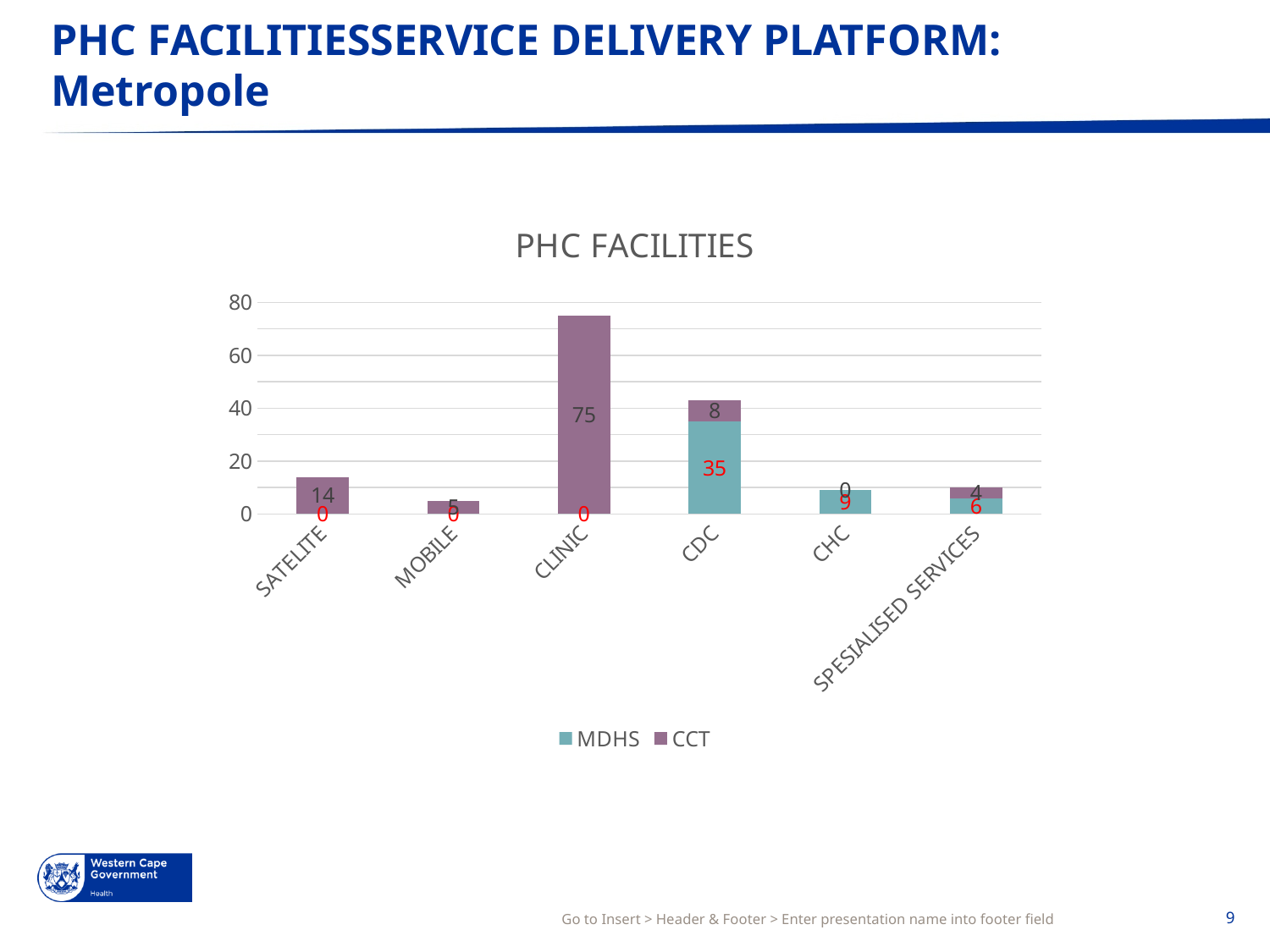
How many categories are shown on the x axis? 6 What is the CCT value for CLINIC? 75 What type of chart is shown on the slide? stacked bar chart Which is larger for SPESIALISED SERVICES, the MDHS value or the CCT value? MDHS What is the MDHS value for CHC? 9 Which category has the highest CCT value? CLINIC What is the MDHS value for CDC? 35 What is the CCT value for SATELITE? 14 What is the total of the stacked bar for CDC? 43 What is the title of the chart? PHC FACILITIES How many series does the legend list? 2 What is the difference between the CCT value for CLINIC and the CCT value for SATELITE? 61